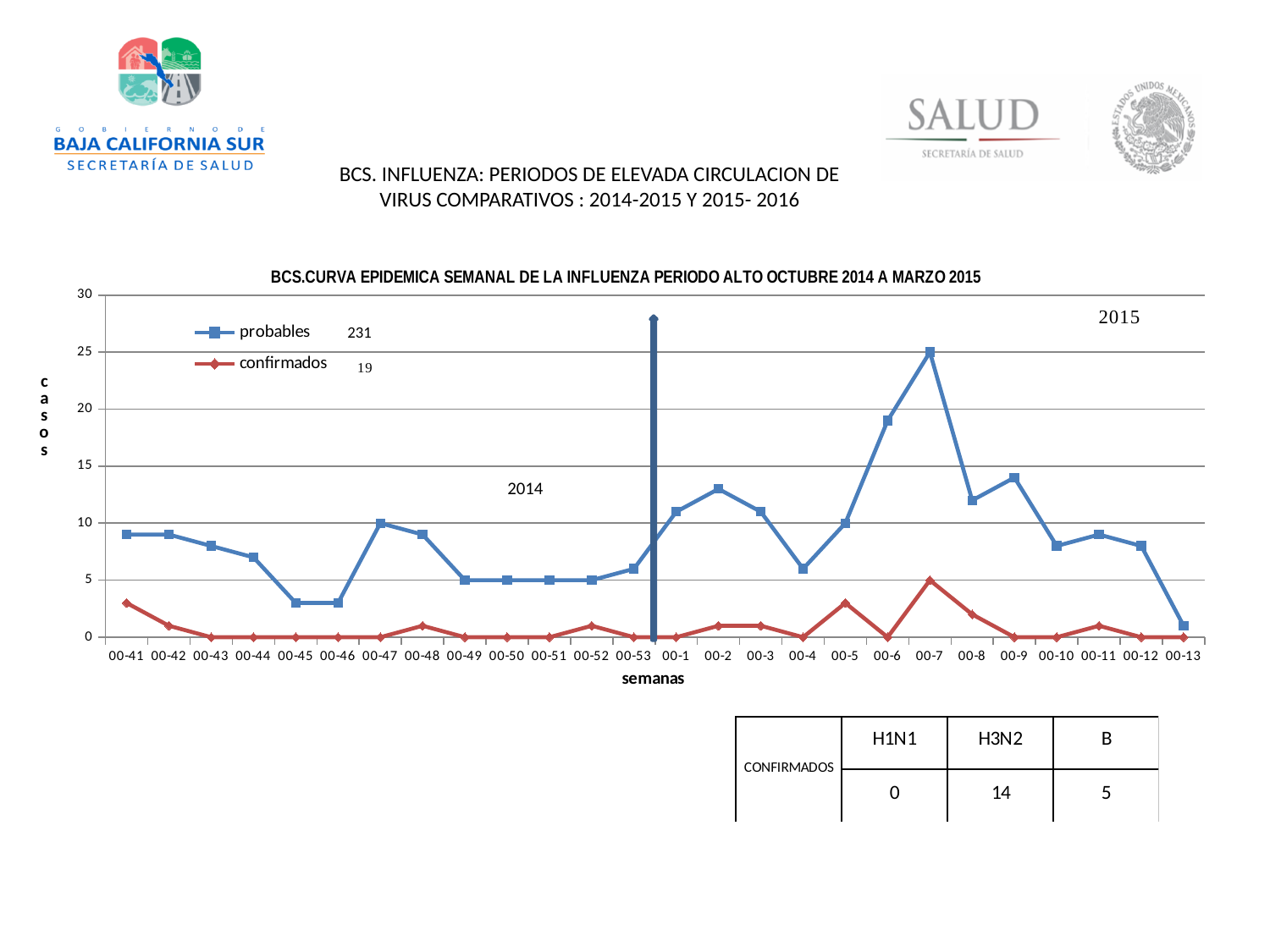
How many weeks (categories) are plotted along the x axis? 26 Is the value of probables in week 00-13 greater or less than 5? less In which week does the probables series reach its highest value? 00-7 Do the probables values rise or fall from week 00-7 to week 00-13? fall How many series does the chart legend list? 2 What is the value of confirmados in week 00-7? 5 What kind of chart is shown on the slide? line chart Is the value of probables in week 00-6 greater or less than 15? greater What total is printed next to the 'probables' legend entry? 231 Which is larger, the probables value in week 00-7 or in week 00-2? 00-7 What is the value of probables in week 00-47? 10 What is the value of probables in week 00-7? 25